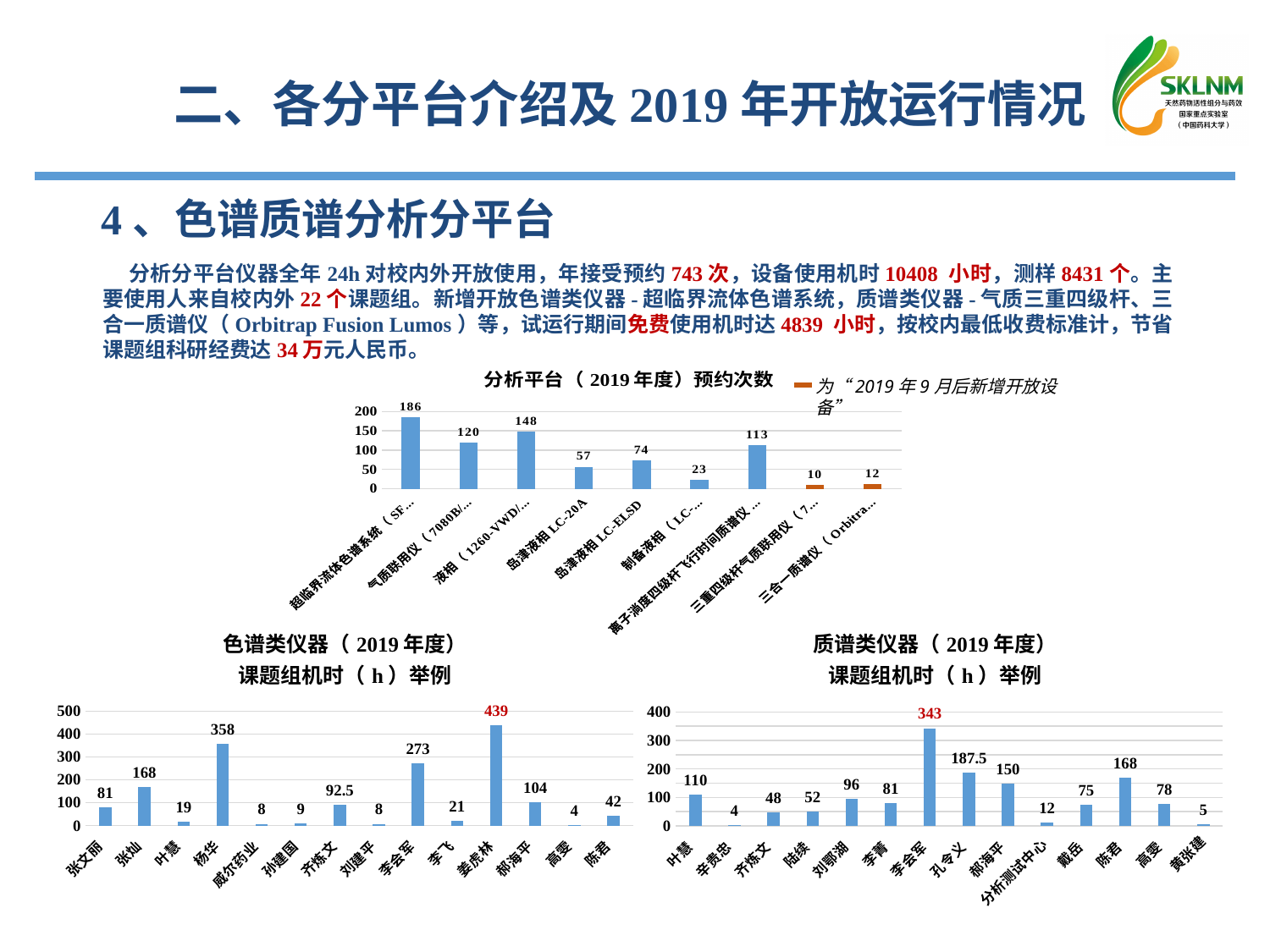
In the top chart '分析平台（2019年度）预约次数', what is the value for 岛津液相 LC-ELSD? 74 In the bottom-left chart '色谱类仪器（2019年度）课题组机时（h）举例', what is the value for 姜虎林? 439 In the bottom-right chart '质谱类仪器（2019年度）课题组机时（h）举例', how many categories are shown on the x axis? 14 In the bottom-left chart '色谱类仪器（2019年度）课题组机时（h）举例', which is larger, 张灿 or 郝海平? 张灿 In the bottom-right chart '质谱类仪器（2019年度）课题组机时（h）举例', what is the value for 孔令义? 187.5 In the top chart '分析平台（2019年度）预约次数', how many bars are plotted? 9 In the bottom-right chart '质谱类仪器（2019年度）课题组机时（h）举例', which category has the highest value? 李会军 What kind of chart is the bottom-right chart '质谱类仪器（2019年度）课题组机时（h）举例'? bar chart In the top chart '分析平台（2019年度）预约次数', what is the value for 岛津液相 LC-20A? 57 In the bottom-left chart '色谱类仪器（2019年度）课题组机时（h）举例', what is the difference between 杨华 and 李会军? 85 In the bottom-left chart '色谱类仪器（2019年度）课题组机时（h）举例', which category has the highest value? 姜虎林 In the top chart '分析平台（2019年度）预约次数', what is the highest value shown? 186